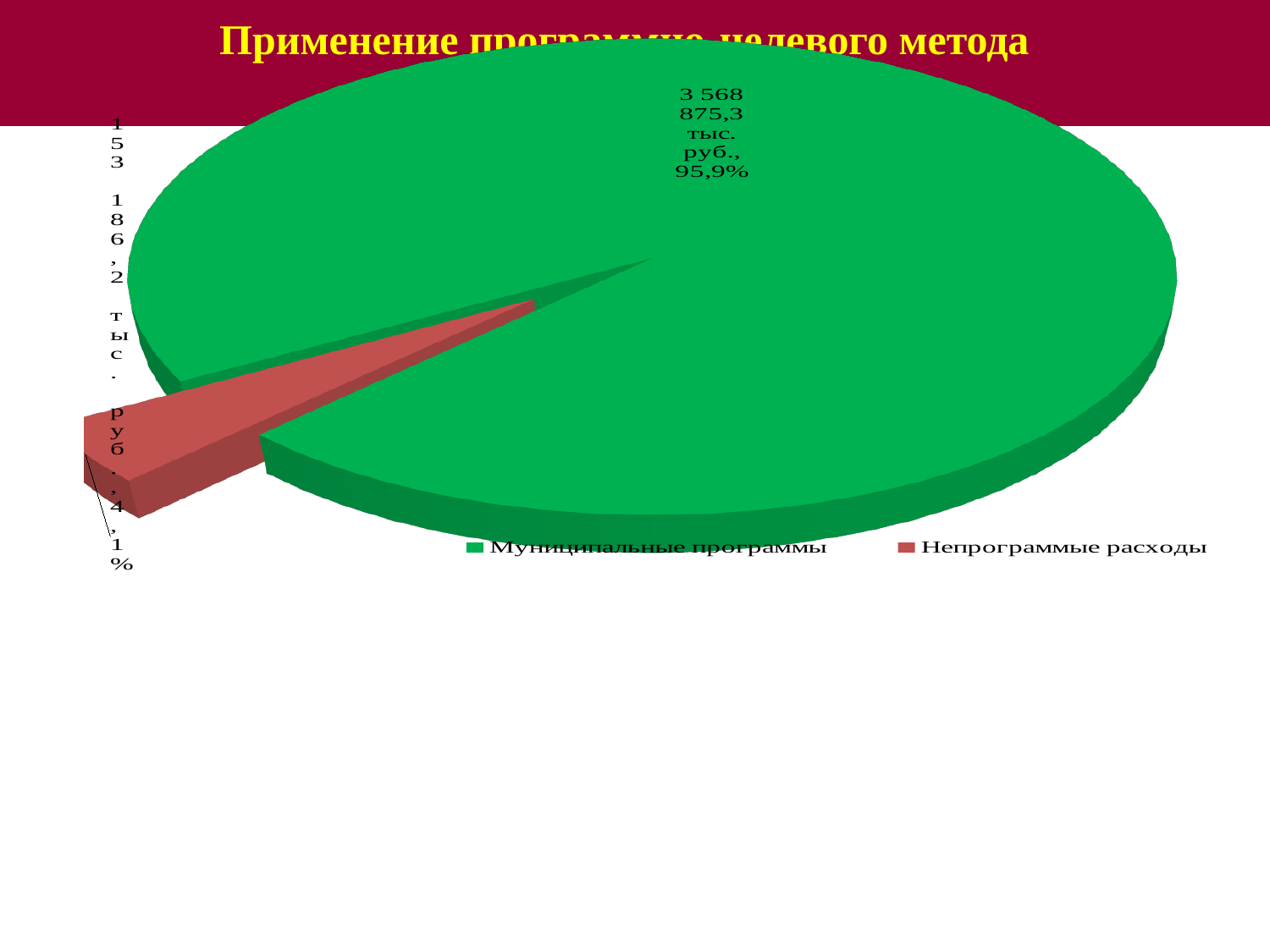
What percentage share does the slice for Муниципальные программы have? 95,9% Which slice of the pie chart is the smallest? Непрограммые расходы Which slice of the pie chart is the largest? Муниципальные программы What kind of chart is shown on the slide? pie chart What value in тыс. руб. is shown for Непрограммые расходы? 153 186,2 тыс. руб. What is the difference in percentage points between the shares of Муниципальные программы and Непрограммые расходы? 91,8 What value in тыс. руб. is shown for Муниципальные программы? 3 568 875,3 тыс. руб. Which is larger, the share for Муниципальные программы or the share for Непрограммые расходы? Муниципальные программы How many entries does the legend of the pie chart list? 2 What percentage share does the slice for Непрограммые расходы have? 4,1% What colour is the slice for Непрограммые расходы? red How many slices does the pie chart have? 2